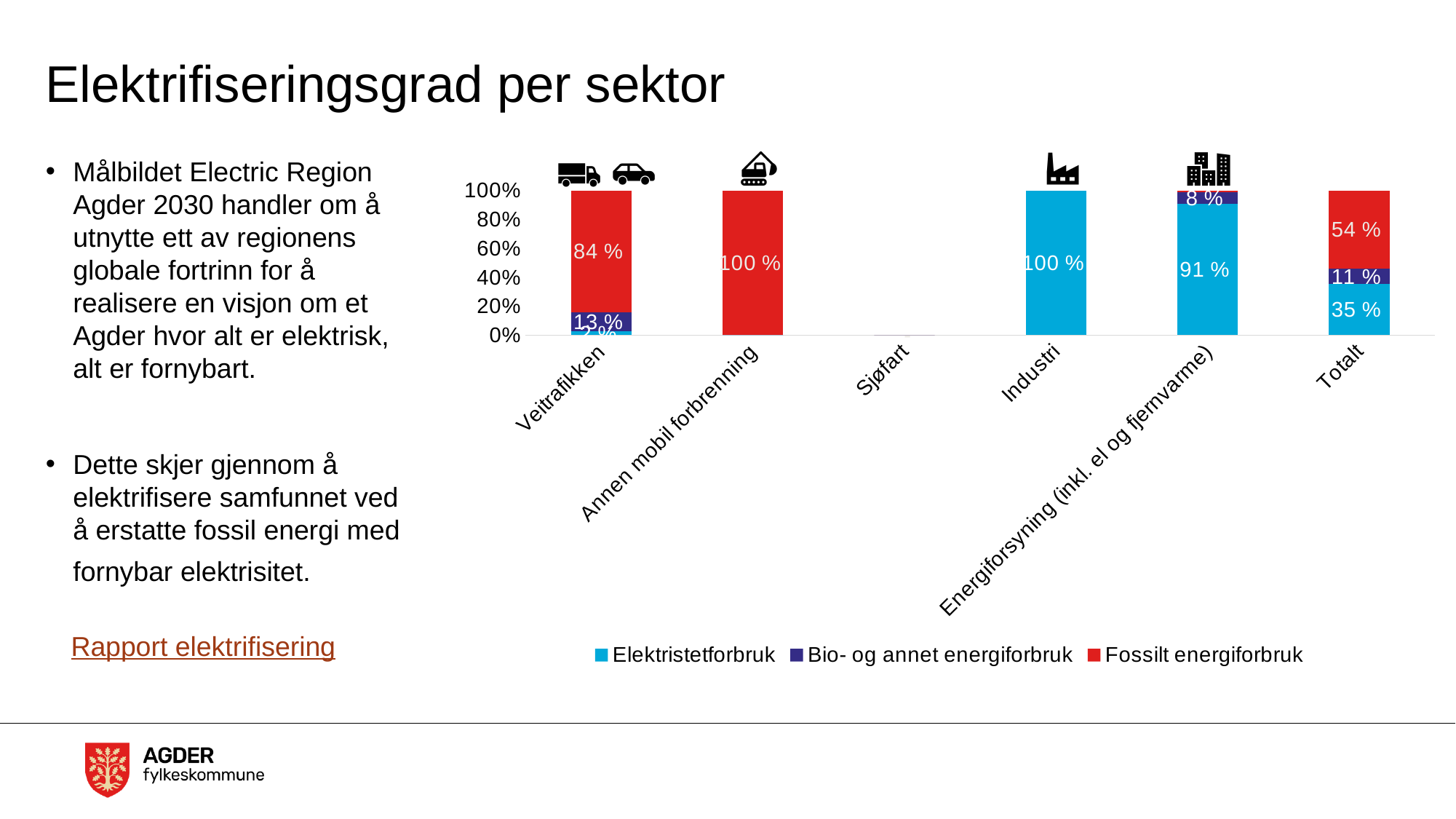
How many series does the legend list? 3 What is the difference between Fossilt energiforbruk and Elektristetforbruk for Totalt? 19 % What is the value of Fossilt energiforbruk for Veitrafikken? 84 % How many categories are shown on the x axis of the chart? 6 What is the value of Elektristetforbruk for Industri? 100 % What is the value of Elektristetforbruk for Energiforsyning (inkl. el og fjernvarme)? 91 % What kind of chart is shown on the slide? Stacked bar chart What is the value of Bio- og annet energiforbruk for Veitrafikken? 13 % Which is larger for Totalt: Fossilt energiforbruk or Bio- og annet energiforbruk? Fossilt energiforbruk What is the value of Fossilt energiforbruk for Totalt? 54 % What is the value of Fossilt energiforbruk for Annen mobil forbrenning? 100 % Which colour represents Elektristetforbruk in the chart? Light blue